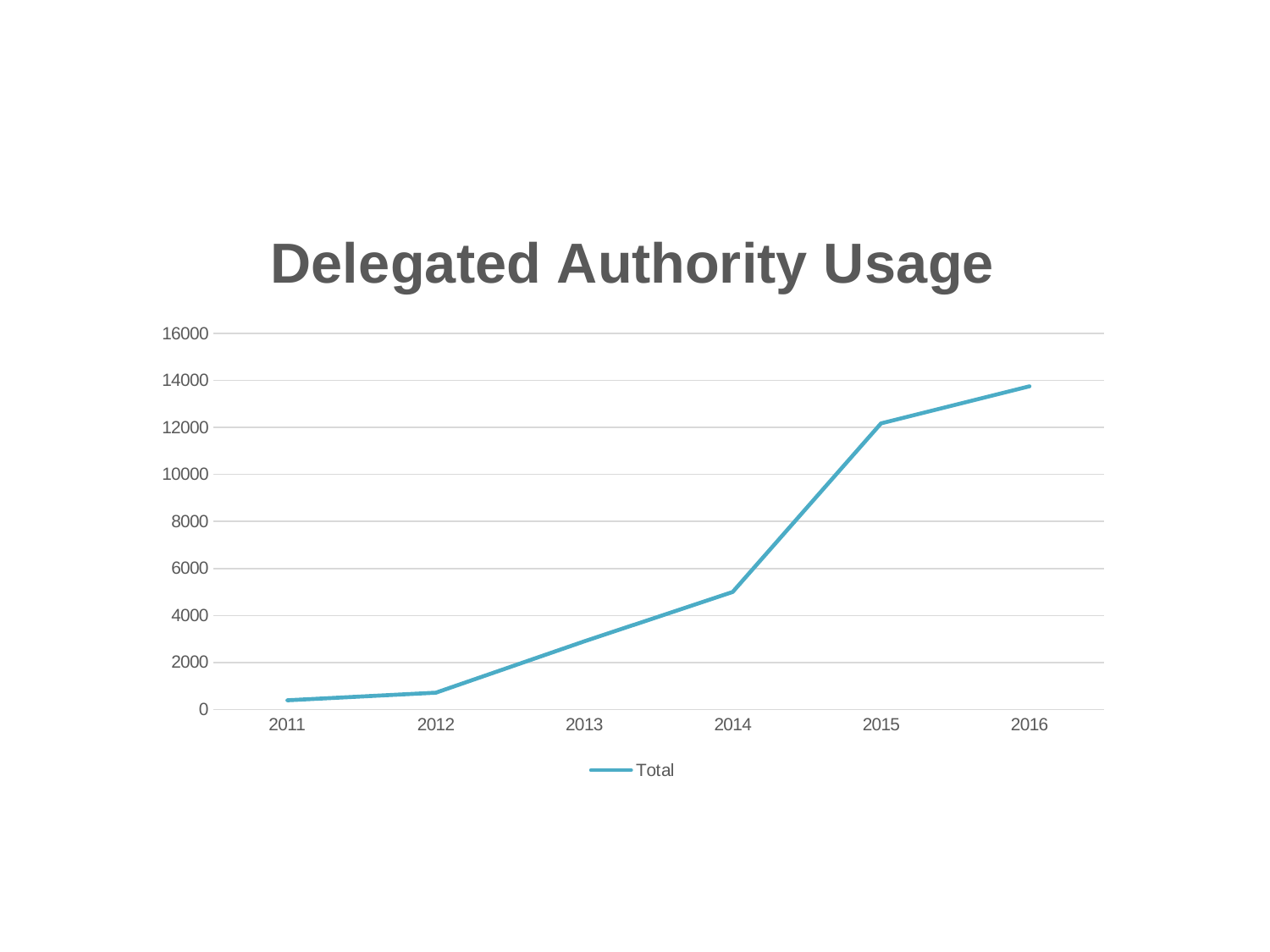
Does the Total value rise or fall from 2011 to 2016? rise Which year has the lowest value for Total? 2011 What type of chart is shown on the slide? line chart What is the title of the chart? Delegated Authority Usage How many years are plotted along the x axis? 6 Is the value for 2011 greater or less than 2000? less Which year has the highest value for Total? 2016 Is the value for 2015 greater or less than 10000? greater How many series does the legend list? 1 Which year has the larger Total value, 2013 or 2015? 2015 What is the name of the series shown in the legend? Total Is the value for 2014 greater or less than 6000? less